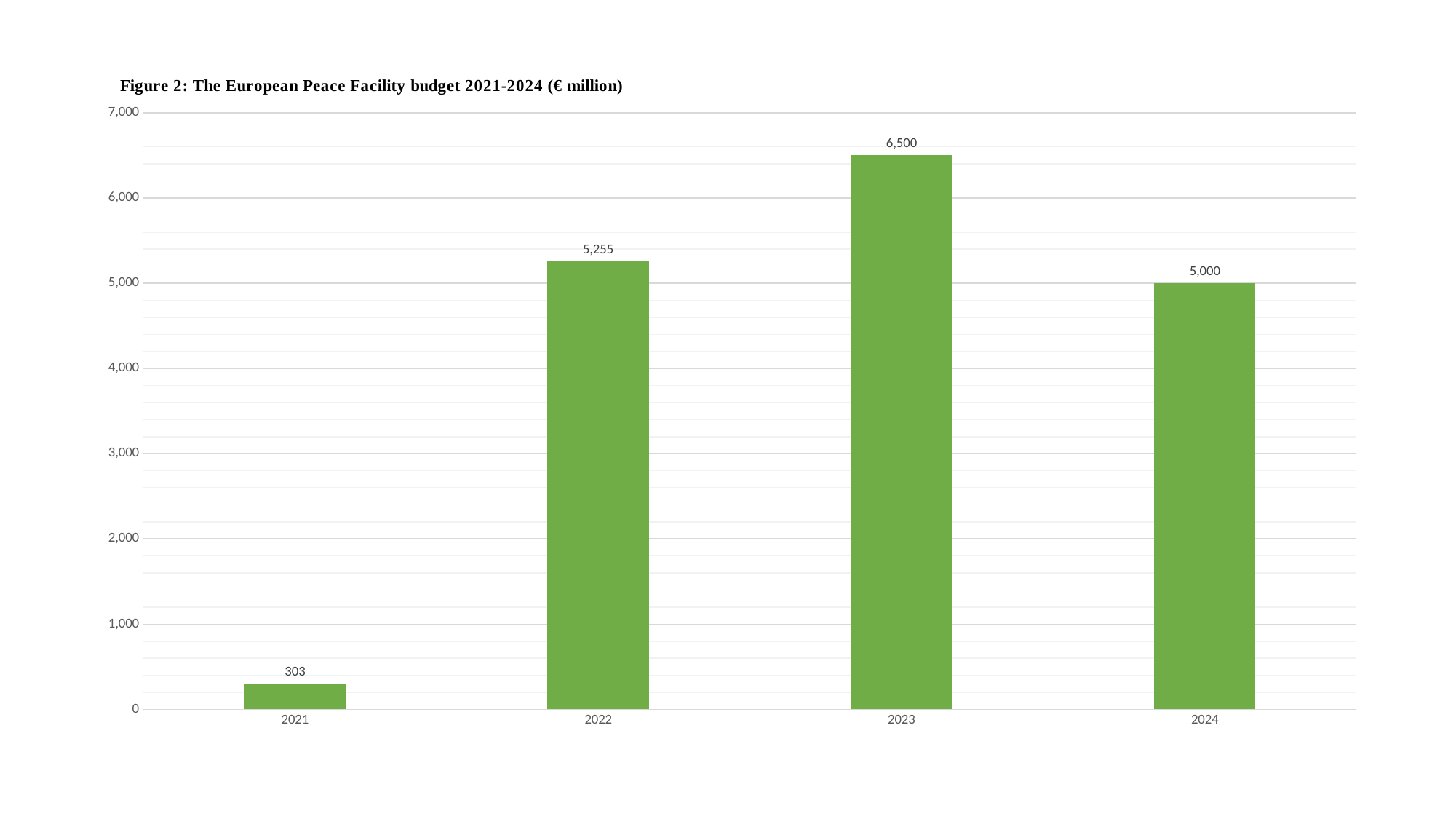
What kind of chart is shown on the slide? Bar chart What is the European Peace Facility budget for 2021? 303 What is the European Peace Facility budget for 2022? 5,255 Which year has the lowest budget? 2021 What is the European Peace Facility budget for 2023? 6,500 What is the difference between the 2022 and 2021 budgets? 4,952 How many years are shown on the chart? 4 What is the European Peace Facility budget for 2024? 5,000 Which year has the highest budget? 2023 Which year has a larger budget, 2022 or 2024? 2022 What is the title of the chart? Figure 2: The European Peace Facility budget 2021-2024 (€ million) What is the difference between the 2023 and 2024 budgets? 1,500